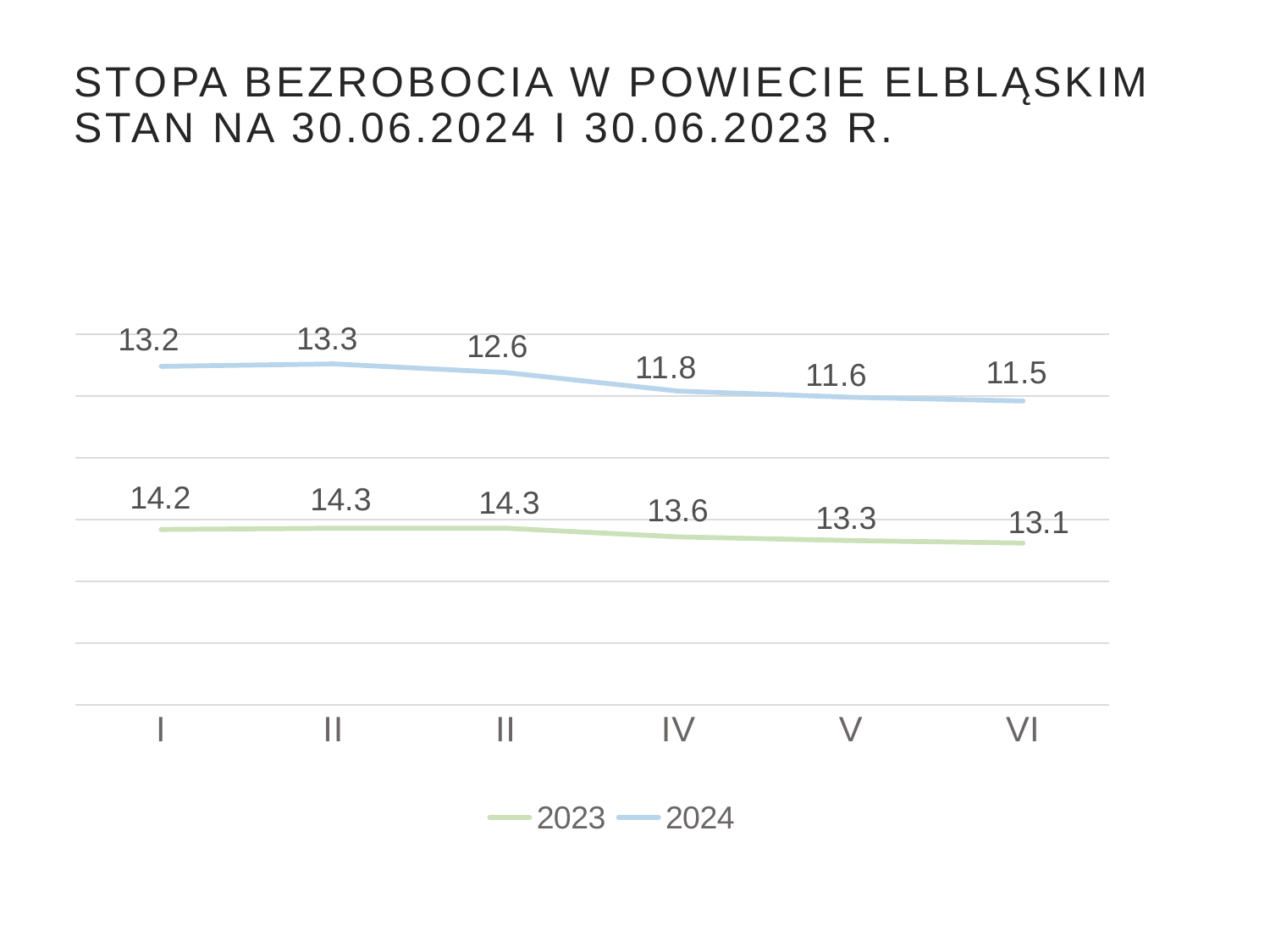
Do the values of the 2024 series rise or fall overall from I to VI? Fall Which series has the larger value at I, 2023 or 2024? 2023 What is the value for the 2024 series at IV? 11.8 How many points are plotted along the x axis for each series? 6 How many series does the legend list? 2 At which x-axis category is the 2024 series highest? II What is the value for the 2023 series at VI? 13.1 What is the difference between the 2023 and 2024 values at VI? 1.6 What is the value for the 2024 series at I? 13.2 What type of chart is shown on the slide? Line chart At which x-axis category is the 2024 series lowest? VI What is the value for the 2023 series at V? 13.3